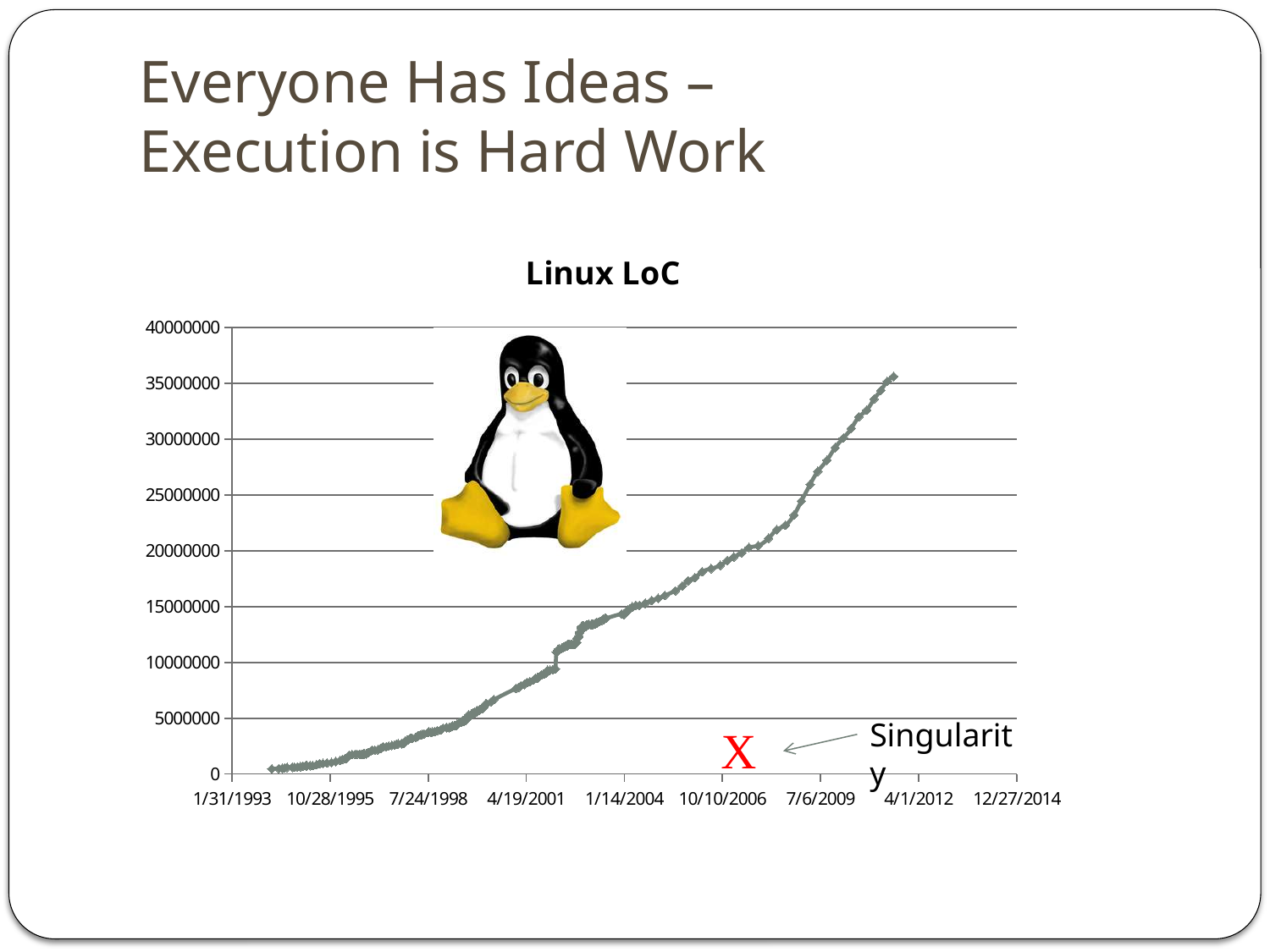
What is the highest value shown on the y axis of the chart? 40000000 Is the last plotted value in the series greater or less than 30000000? greater Is the value around 7/6/2009 greater or less than 20000000? greater Is the value around 4/19/2001 greater or less than 10000000? less Do the values in the Linux LoC chart rise or fall over time along the x axis? rise Is the chart a bar chart or a line chart? line chart What is the title of the chart? Linux LoC Is the value at 7/6/2009 larger or smaller than the value at 4/19/2001? larger